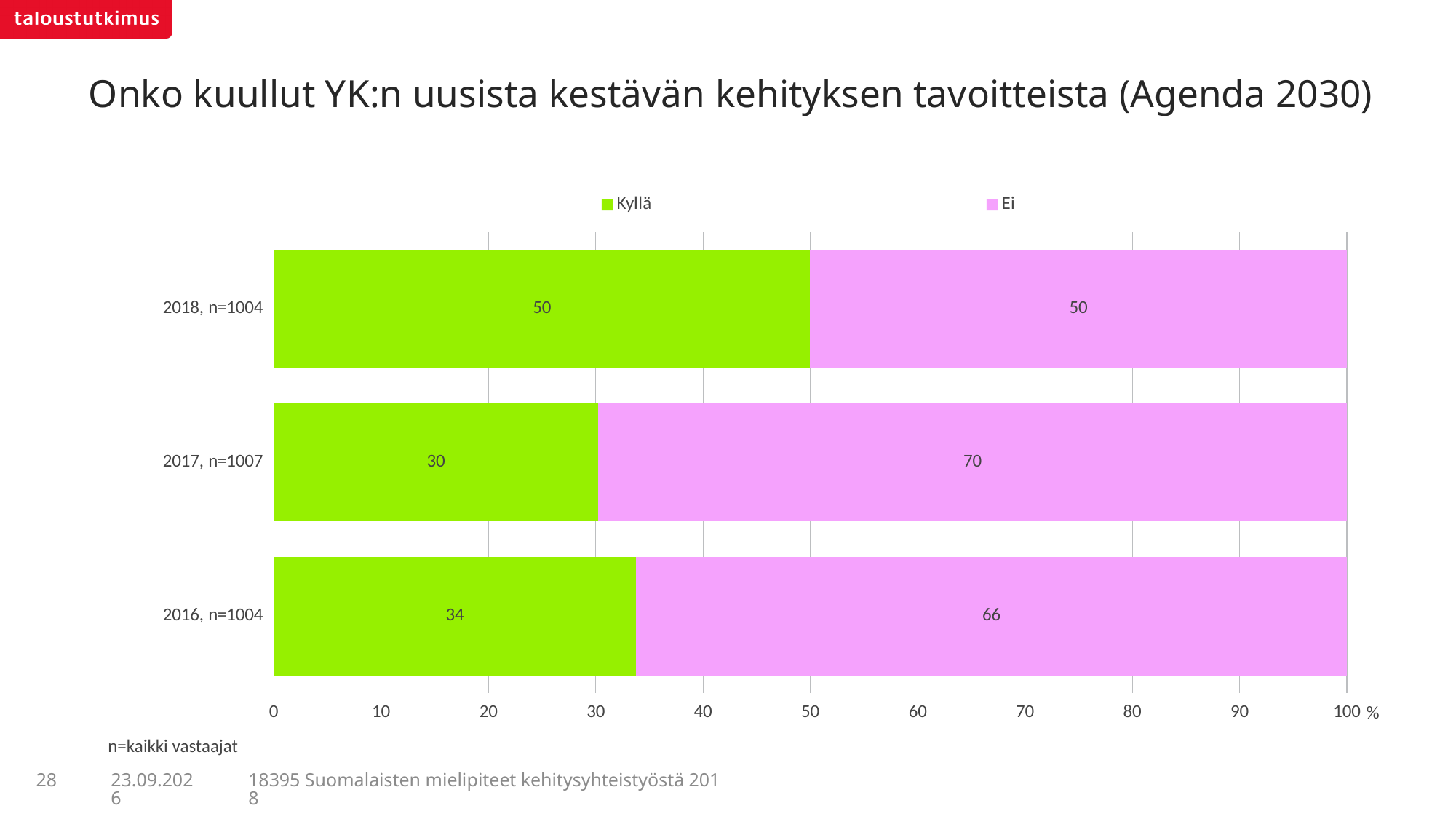
Which year has the highest Kyllä value? 2018, n=1004 Which colour represents the Ei series in the legend? Pink How many categories (years) are shown on the chart? 3 What is the Kyllä value for 2018, n=1004? 50 What is the total of the stacked bar for 2018, n=1004? 100 What is the Ei value for 2017, n=1007? 70 What is the difference between the Ei value for 2017, n=1007 and the Ei value for 2016, n=1004? 4 What kind of chart is shown on the slide? Stacked bar chart How many series does the legend list? 2 What is the Kyllä value for 2016, n=1004? 34 Which year has the lowest Kyllä value? 2017, n=1007 Which is larger: the Kyllä value for 2016, n=1004 or the Kyllä value for 2017, n=1007? 2016, n=1004